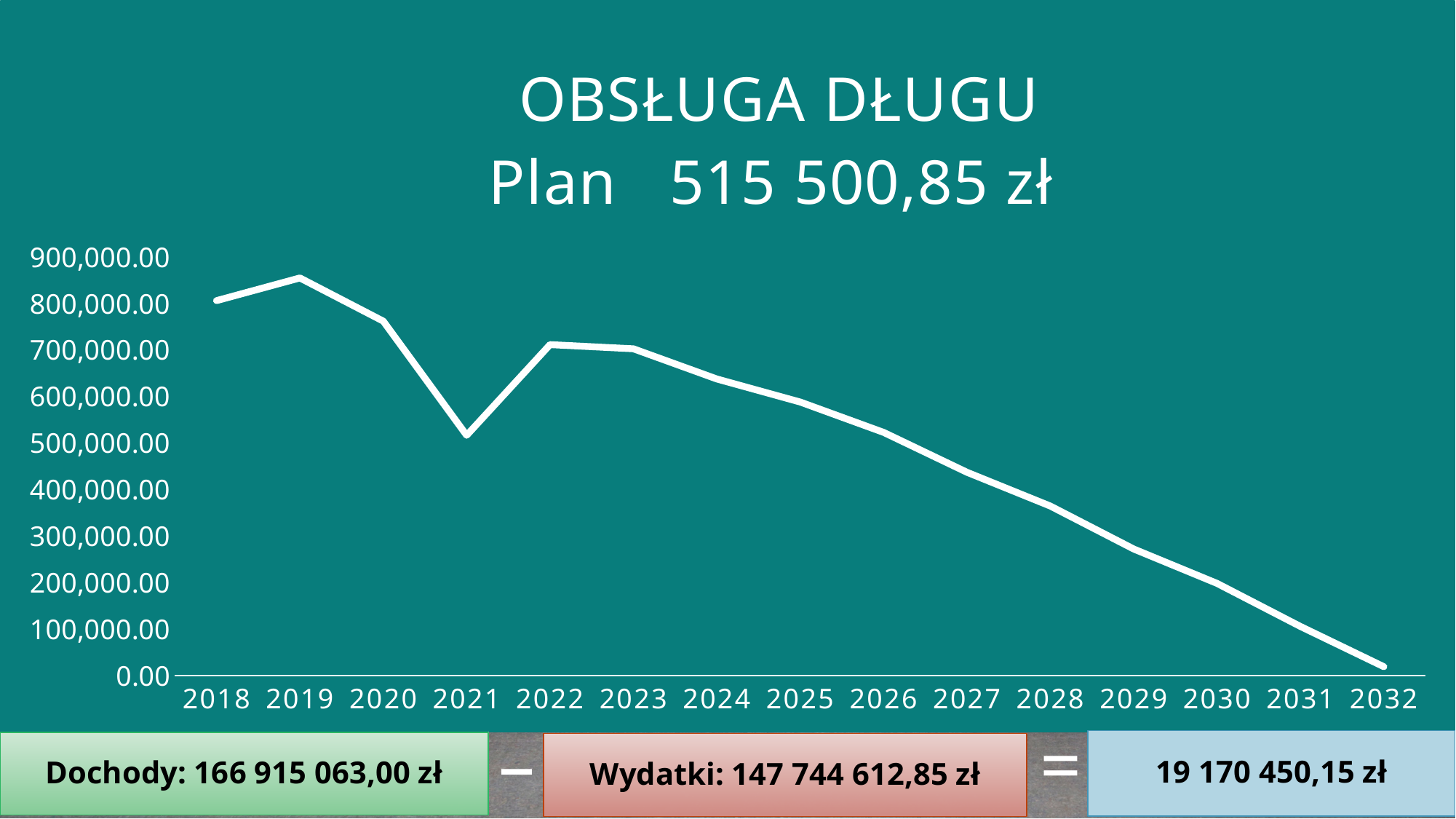
Which year has the lowest value on the line? 2032 How many years are plotted along the x axis? 15 Is the value for 2028 greater or less than 400,000.00? less Which year has the larger value, 2019 or 2021? 2019 What is the title of the chart? OBSŁUGA DŁUGU Do the values generally rise or fall from 2023 to 2032? fall What kind of chart is shown on the slide? line chart Which year has the highest value on the line? 2019 Is the value for 2032 greater or less than 100,000.00? less Is the value for 2019 greater or less than 800,000.00? greater What plan value is stated in the chart's subtitle? 515 500,85 zł